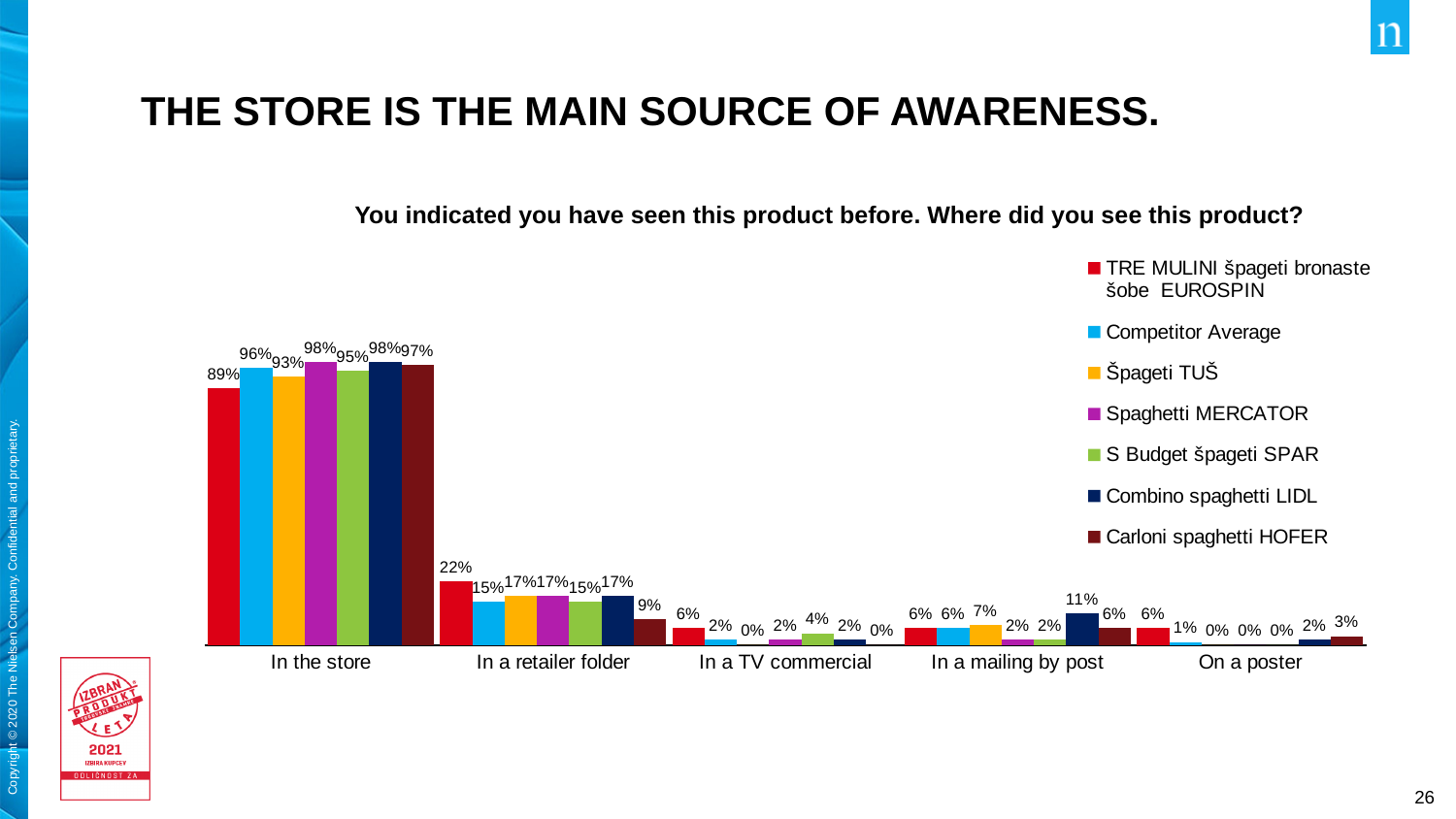
What type of chart is shown on the slide? Bar chart What is the Competitor Average value for 'In a retailer folder'? 15% How many categories are shown on the x axis? 5 What percentage of TRE MULINI špageti bronaste šobe EUROSPIN respondents saw the product in the store? 89% What value is shown for Carloni spaghetti HOFER in the 'On a poster' category? 3% What is the difference between the TRE MULINI špageti bronaste šobe EUROSPIN value and the Competitor Average value for 'In the store'? 7% What value is shown for Combino spaghetti LIDL in the 'In a mailing by post' category? 11% Which is larger for 'In a TV commercial': the value for S Budget špageti SPAR or the value for Spaghetti MERCATOR? S Budget špageti SPAR Which series has the lowest value in the 'In the store' category? TRE MULINI špageti bronaste šobe EUROSPIN How many series does the legend list? 7 What question is shown as the chart's subtitle? You indicated you have seen this product before. Where did you see this product? Which series has the highest value in the 'In a retailer folder' category? TRE MULINI špageti bronaste šobe EUROSPIN